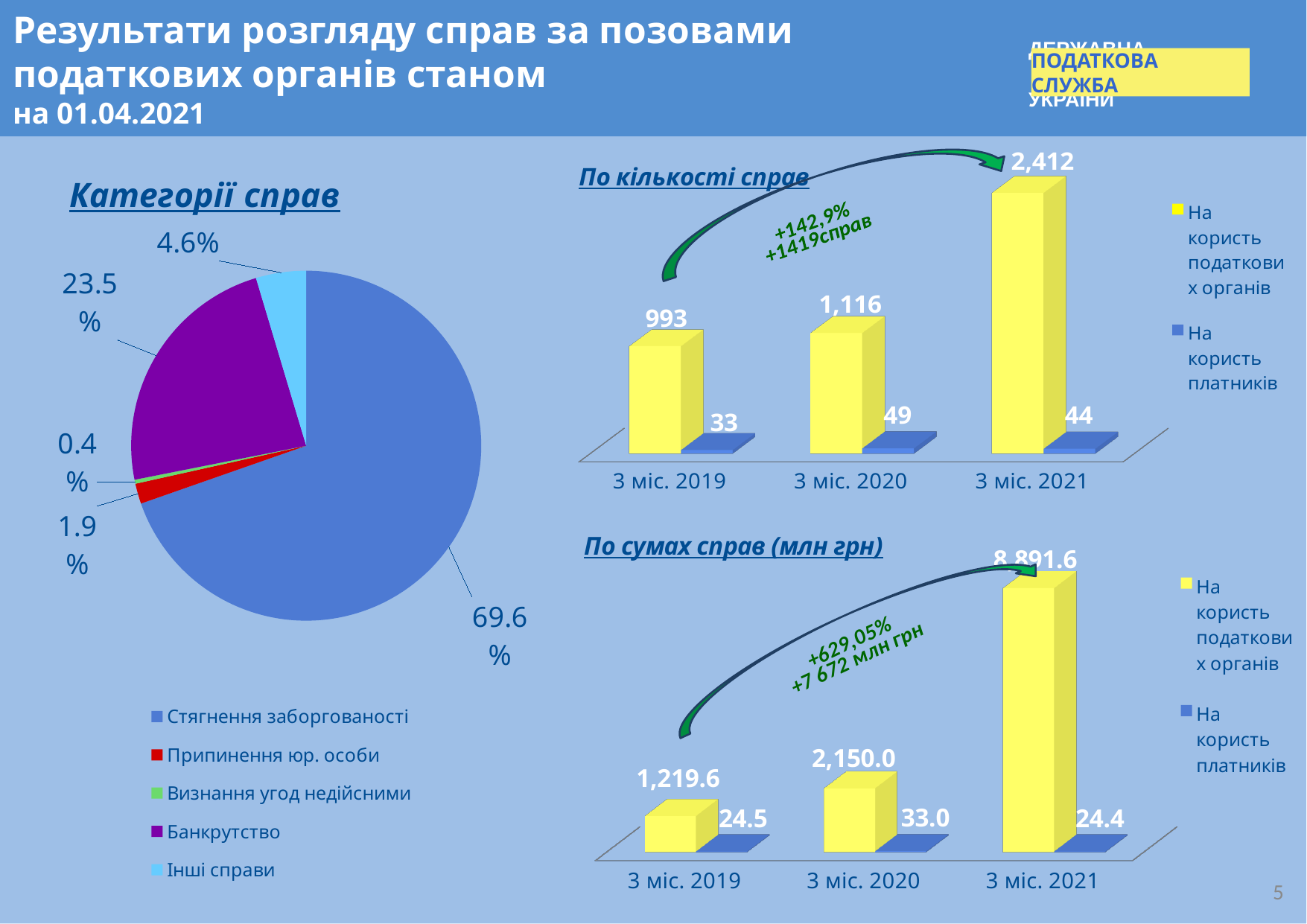
What kind of chart is "По сумах справ (млн грн)"? bar chart In the chart "По сумах справ (млн грн)", what is the value for "На користь податкових органів" in 3 міс. 2019? 1,219.6 In the chart "По кількості справ", what is the difference between the "На користь податкових органів" values for 3 міс. 2021 and 3 міс. 2020? 1,296 In the chart "По кількості справ", what is the value for "На користь податкових органів" in 3 міс. 2021? 2,412 In the pie chart "Категорії справ", which category has the largest share? Стягнення заборгованості In the chart "По сумах справ (млн грн)", which period has the highest value for "На користь платників"? 3 міс. 2020 In the chart "По кількості справ", does the "На користь податкових органів" series rise or fall from 3 міс. 2019 to 3 міс. 2021? rise In the chart "По кількості справ", what is the value for "На користь платників" in 3 міс. 2020? 49 In the pie chart "Категорії справ", what share does "Банкрутство" have? 23.5% In the pie chart "Категорії справ", which category has the smallest share? Визнання угод недійсними How many series does the legend of the chart "По сумах справ (млн грн)" list? 2 How many categories does the legend of the pie chart "Категорії справ" list? 5